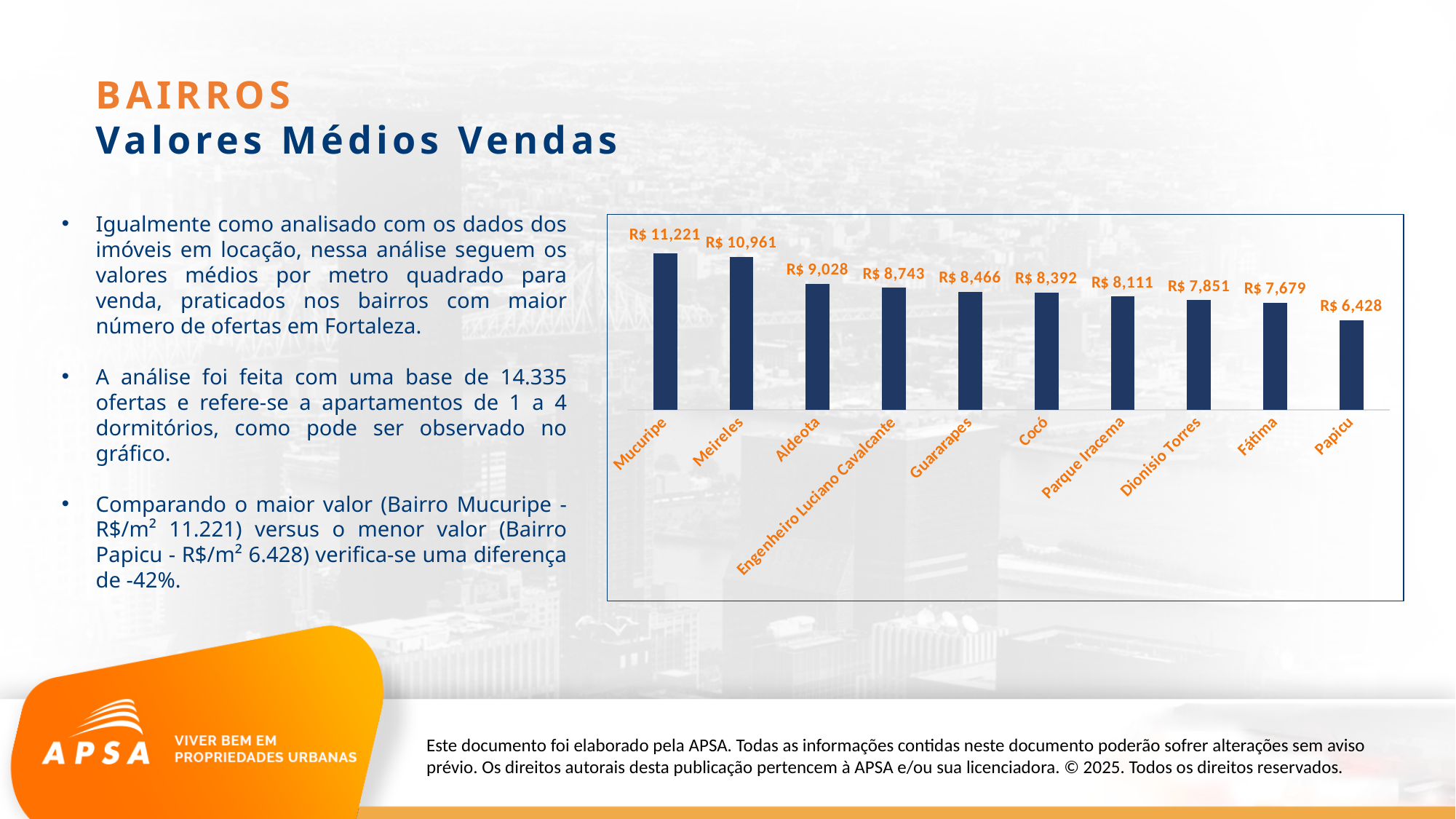
What is the value shown for Aldeota? R$ 9,028 How many neighbourhoods are shown in the chart? 10 Do the values rise or fall from left to right along the x axis? Fall What is the difference between the values for Meireles and Aldeota? R$ 1,933 What is the difference between the values for Mucuripe and Papicu? R$ 4,793 What is the value shown for Dionisio Torres? R$ 7,851 Which neighbourhood has the highest value in the chart? Mucuripe What is the value shown for Engenheiro Luciano Cavalcante? R$ 8,743 Which neighbourhood has the lowest value in the chart? Papicu What is the value shown for Mucuripe? R$ 11,221 Which has a larger value, Guararapes or Parque Iracema? Guararapes What kind of chart is shown on the slide? Bar chart